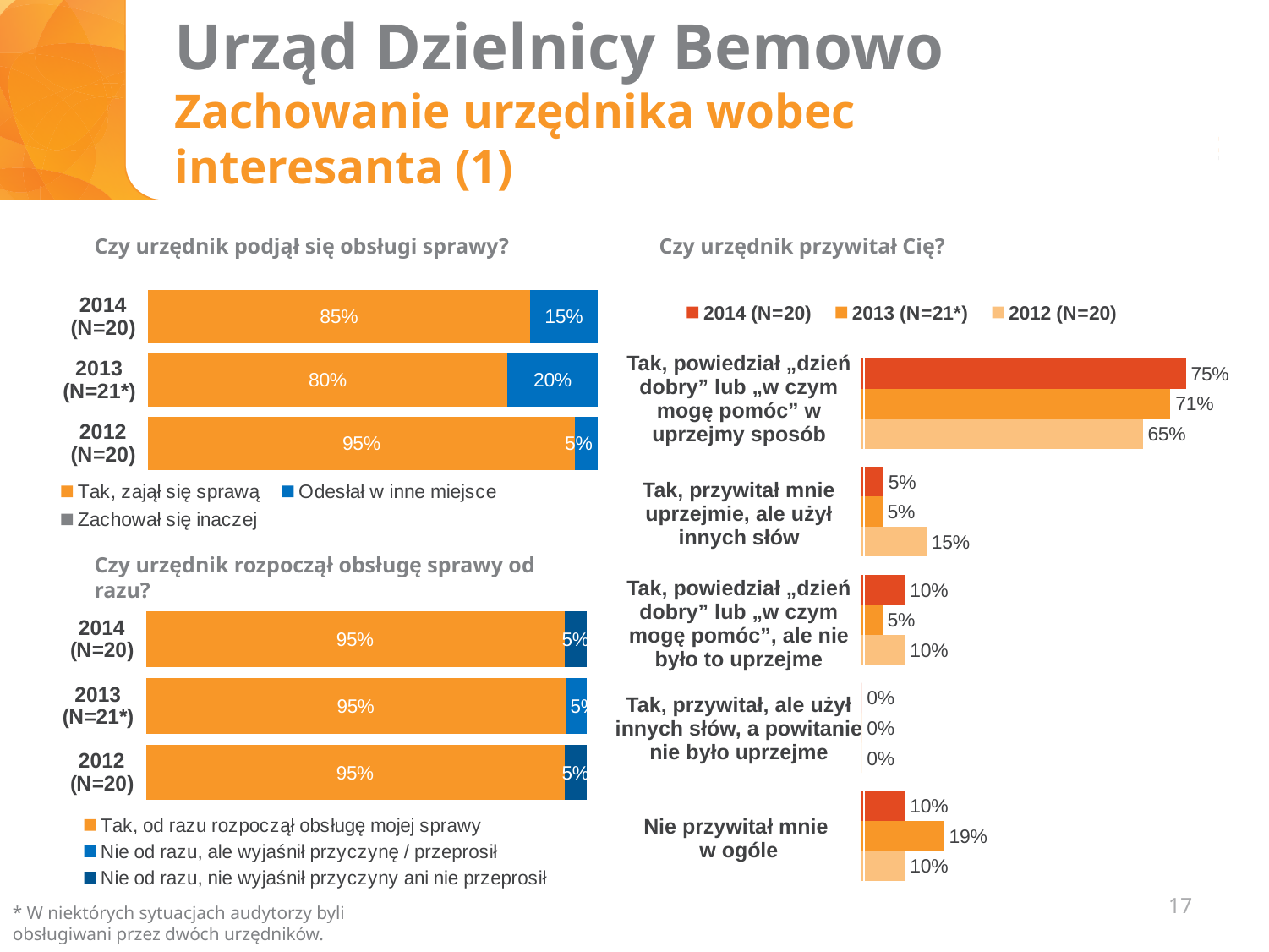
How many series does the legend of the chart 'Czy urzędnik podjął się obsługi sprawy?' list? 3 In the chart 'Czy urzędnik przywitał Cię?', what is the 2014 (N=20) value for 'Tak, powiedział „dzień dobry” lub „w czym mogę pomóc” w uprzejmy sposób'? 75% In the chart 'Czy urzędnik podjął się obsługi sprawy?', what is the difference between the 'Tak, zajął się sprawą' values for 2012 and 2013? 15 percentage points In the chart 'Czy urzędnik przywitał Cię?', is the 2014 value for 'Tak, powiedział „dzień dobry” lub „w czym mogę pomóc” w uprzejmy sposób' larger or smaller than the 2012 value? Larger How many answer categories are shown in the chart 'Czy urzędnik przywitał Cię?'? 5 In the chart 'Czy urzędnik rozpoczął obsługę sprawy od razu?', what percentage for 2012 (N=20) is 'Tak, od razu rozpoczął obsługę mojej sprawy'? 95% In the chart 'Czy urzędnik podjął się obsługi sprawy?', which year has the highest share of 'Tak, zajął się sprawą'? 2012 (N=20) What type of chart is 'Czy urzędnik rozpoczął obsługę sprawy od razu?'? Stacked bar chart In the chart 'Czy urzędnik przywitał Cię?', what is the 2013 (N=21*) value for 'Nie przywitał mnie w ogóle'? 19% In the chart 'Czy urzędnik podjął się obsługi sprawy?', what percentage for 2014 (N=20) is 'Tak, zajął się sprawą'? 85% In the chart 'Czy urzędnik podjął się obsługi sprawy?', what percentage for 2013 (N=21*) is 'Odesłał w inne miejsce'? 20% In the chart 'Czy urzędnik przywitał Cię?', which year has the highest value for 'Tak, przywitał mnie uprzejmie, ale użył innych słów'? 2012 (N=20)